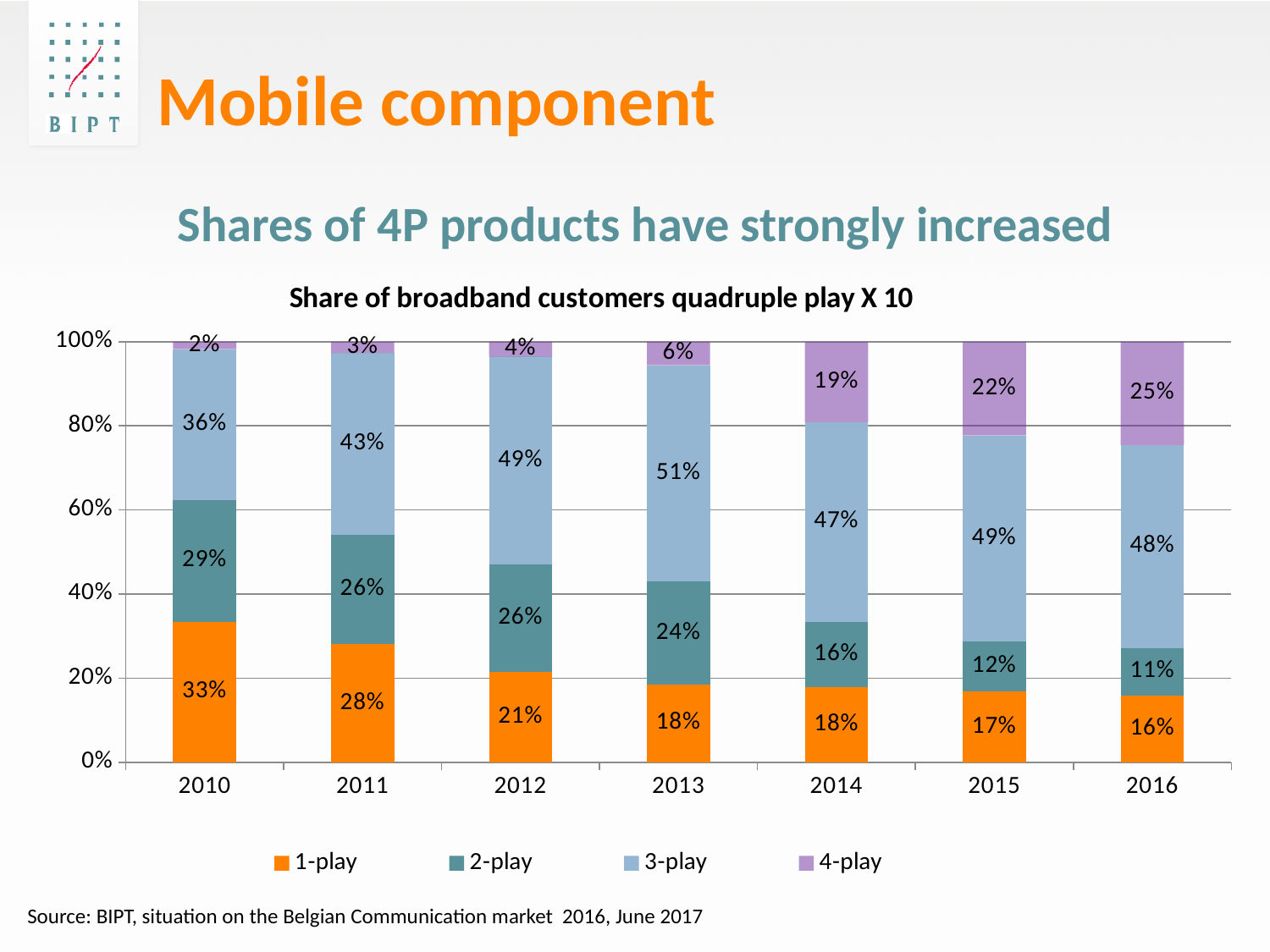
Which is larger, the 2-play share in 2011 or the 2-play share in 2015? 2-play share in 2011 How many series does the legend list? 4 What is the share of 3-play in 2013? 51% What kind of chart is shown? Stacked bar chart How many years are shown on the x axis? 7 Does the 1-play share rise or fall from 2010 to 2016? Fall In which year is the 4-play share highest? 2016 In which year is the 1-play share lowest? 2016 What is the difference between the 4-play share in 2016 and in 2010? 23% What is the share of 2-play in 2014? 16% What is the share of 4-play in 2016? 25% What is the share of 1-play in 2010? 33%